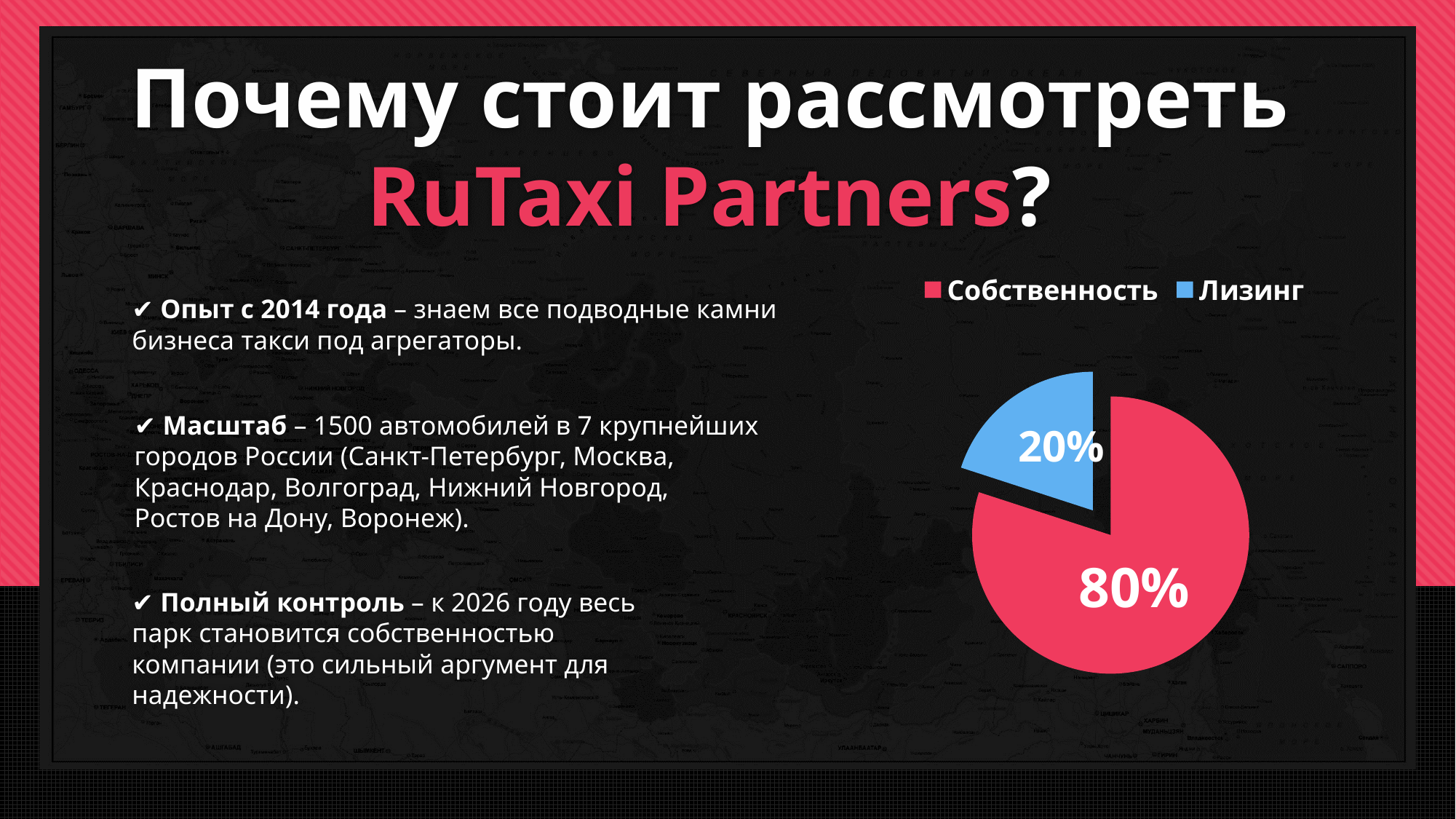
How many entries does the legend list? 2 What colour is the Собственность slice? red Which is larger, the Собственность slice or the Лизинг slice? Собственность Which slice of the pie is the largest? Собственность What share of the pie does Лизинг have? 20% Which slice of the pie is the smallest? Лизинг What is the difference between the Собственность and Лизинг shares? 60% What kind of chart is shown on the slide? pie chart How many slices does the pie chart have? 2 What colour is the Лизинг slice? blue What share of the pie does Собственность have? 80%